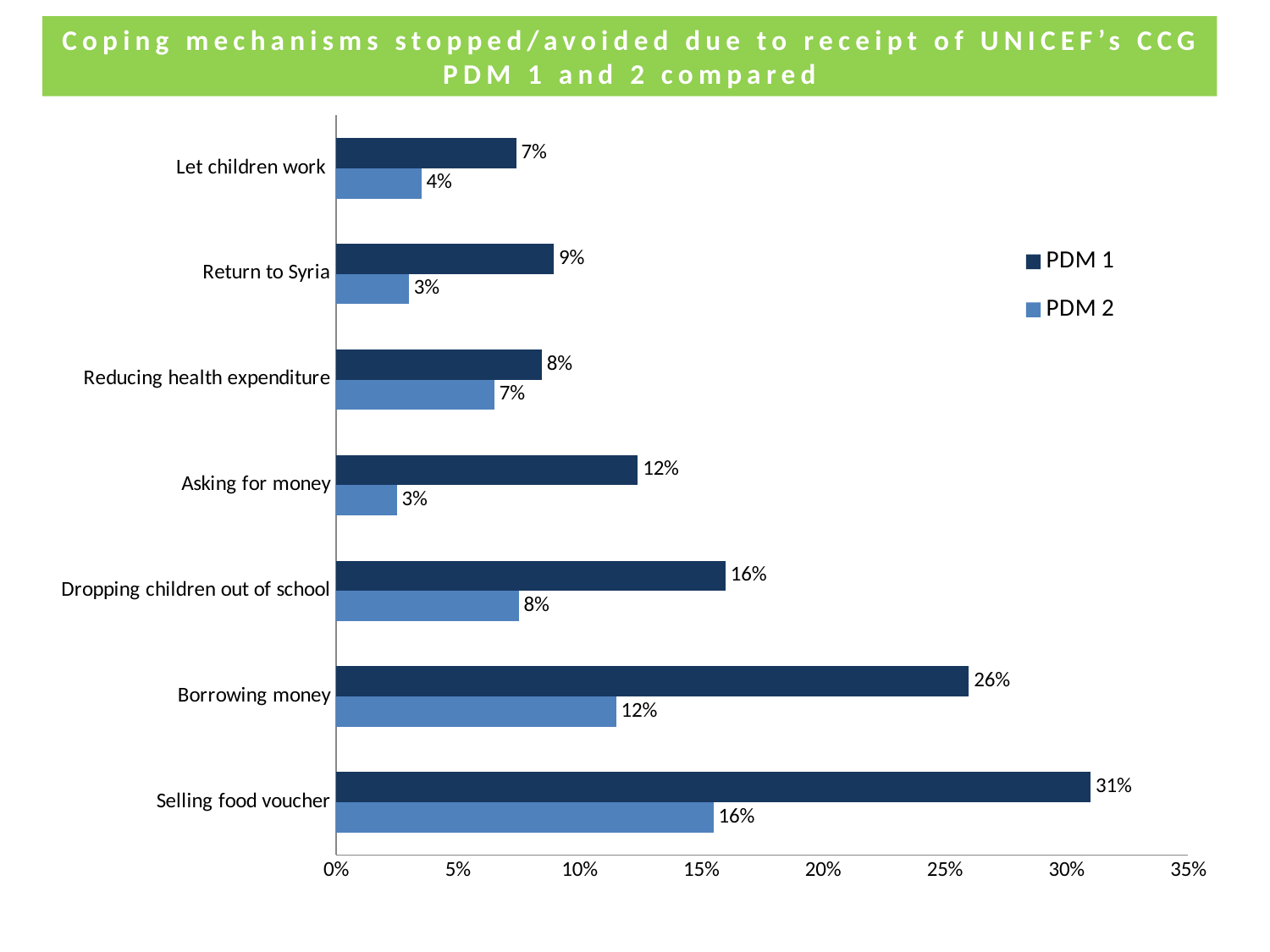
Is the PDM 1 value for Borrowing money greater or less than 25%? greater What is the title of the chart? Coping mechanisms stopped/avoided due to receipt of UNICEF's CCG PDM 1 and 2 compared Which is larger for Asking for money: the PDM 1 value or the PDM 2 value? PDM 1 What is the PDM 2 value for Borrowing money? 12% How many coping mechanism categories are shown on the chart? 7 Which category has the highest PDM 1 value? Selling food voucher Which category has the lowest PDM 1 value? Let children work What is the PDM 1 value for Selling food voucher? 31% What is the difference between the PDM 1 and PDM 2 values for Dropping children out of school? 8% How many series does the legend list? 2 What is the PDM 2 value for Return to Syria? 3% What kind of chart is shown on the slide? Bar chart